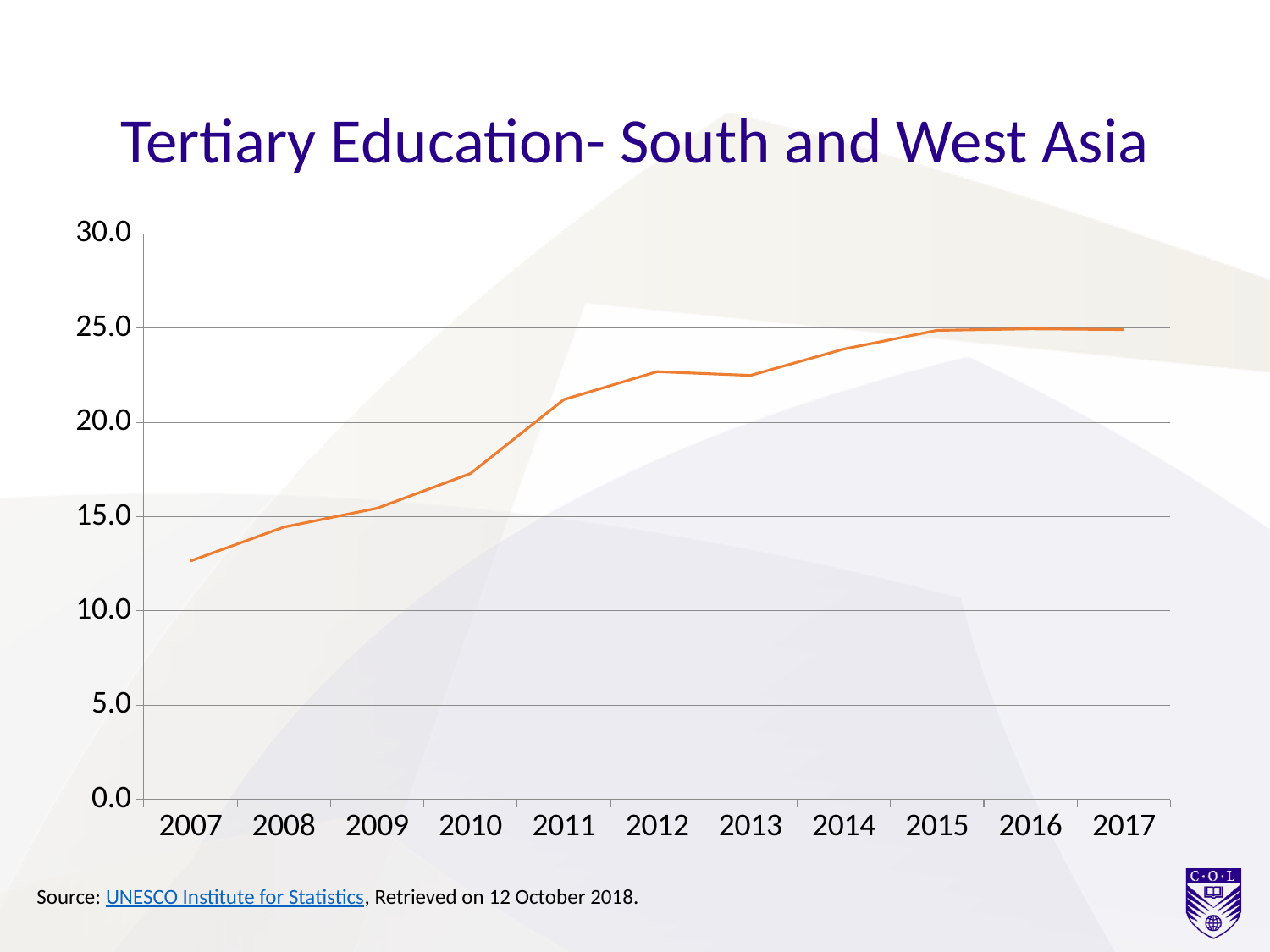
Is the value for 2013 greater or less than 25.0? less Is the value for 2010 greater or less than 20.0? less What is the first year shown on the x axis? 2007 Do the values generally rise or fall from 2007 to 2017? rise What is the title of the chart? Tertiary Education- South and West Asia Is the value for 2007 greater or less than 15.0? less Which year has the lowest value? 2007 What kind of chart is shown on the slide? line chart Which is larger, the value for 2011 or the value for 2008? 2011 How many years are plotted on the x axis? 11